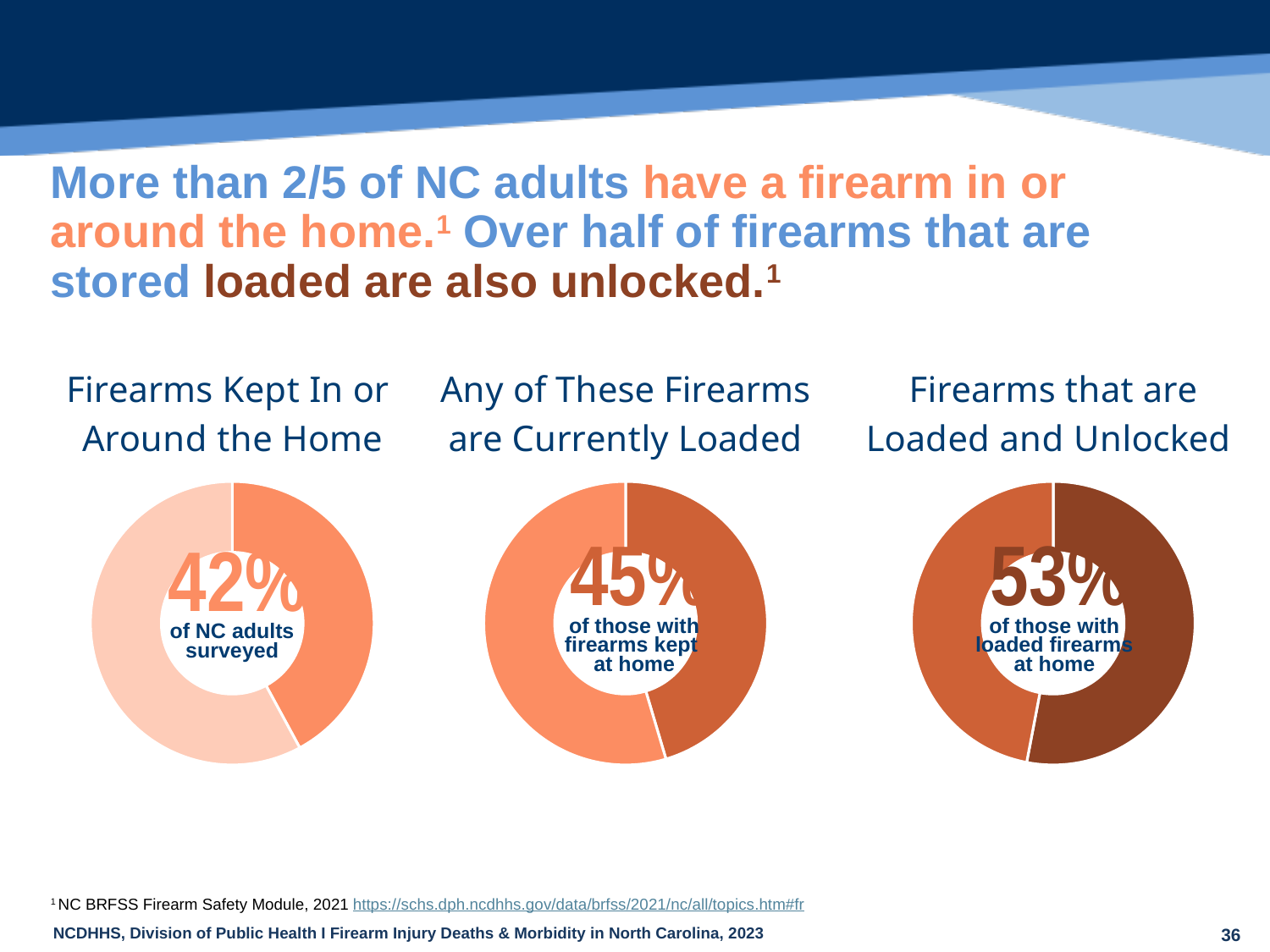
In the 'Firearms Kept In or Around the Home' chart, what percentage of NC adults surveyed is shown? 42% What is the title of the middle chart on the slide? Any of These Firearms are Currently Loaded Which of the three charts shows the highest percentage? Firearms that are Loaded and Unlocked How many donut charts are shown on the slide? 3 In the 'Firearms Kept In or Around the Home' chart, is the highlighted share greater or less than 50%? less What is the difference in percentage points between the 'Firearms that are Loaded and Unlocked' chart (53%) and the 'Firearms Kept In or Around the Home' chart (42%)? 11 percentage points Which of the three charts shows the lowest percentage? Firearms Kept In or Around the Home In the 'Firearms that are Loaded and Unlocked' chart, is the highlighted share greater or less than 50%? greater What kind of chart is used for 'Firearms Kept In or Around the Home'? Donut (pie) chart In the 'Any of These Firearms are Currently Loaded' chart, what percentage of those with firearms kept at home is shown? 45% In the 'Firearms that are Loaded and Unlocked' chart, what percentage of those with loaded firearms at home is shown? 53% Is the percentage in the 'Firearms that are Loaded and Unlocked' chart larger or smaller than the percentage in the 'Any of These Firearms are Currently Loaded' chart? Larger